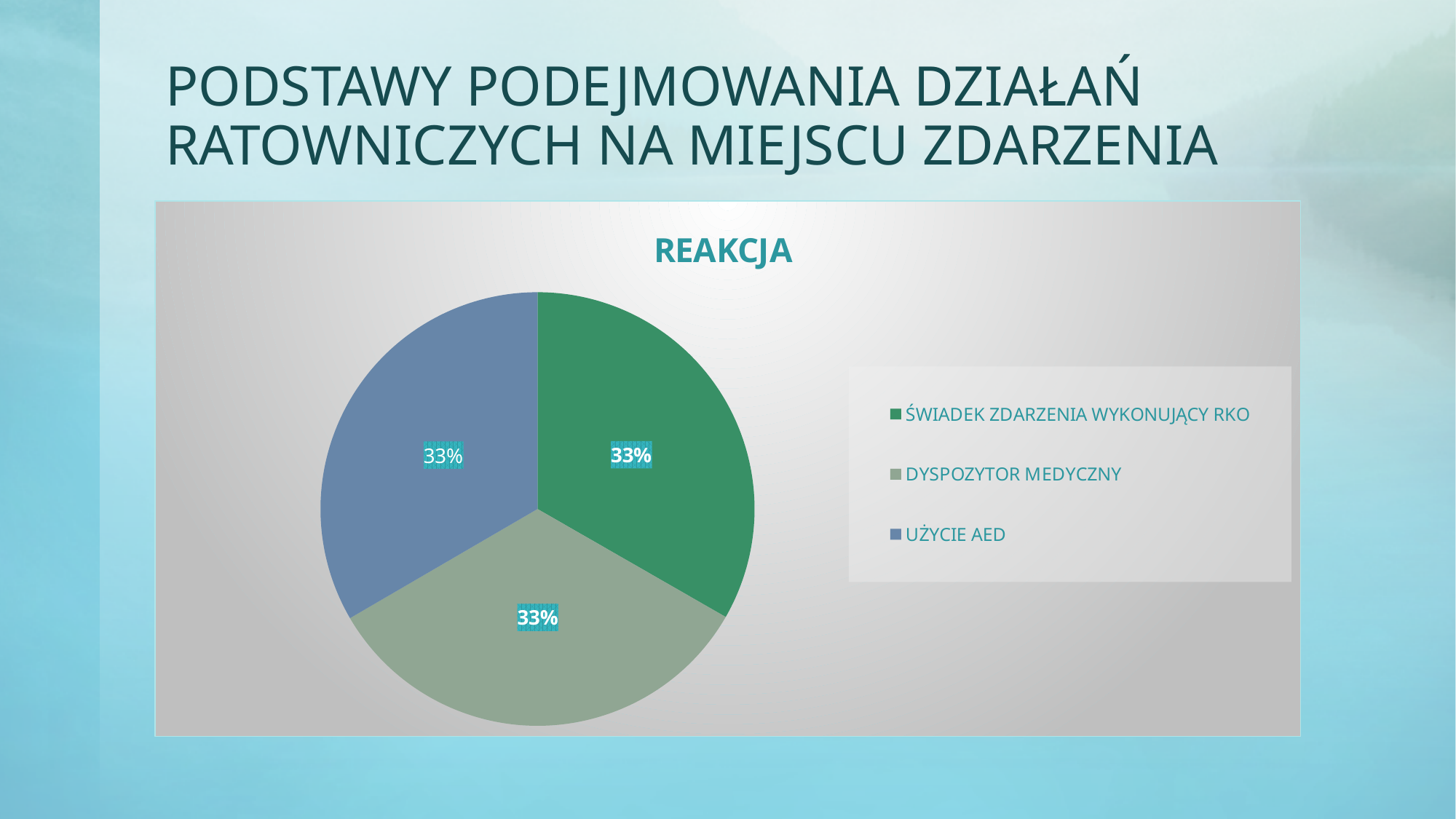
What is the difference between the shares of UŻYCIE AED and DYSPOZYTOR MEDYCZNY? 0% Which legend entry is shown in blue? UŻYCIE AED How many entries does the legend list? 3 What share of the pie does UŻYCIE AED represent? 33% What is the data label shown on the blue slice? 33% What is the title of the chart? REAKCJA How many slices does the pie chart have? 3 What share of the pie does ŚWIADEK ZDARZENIA WYKONUJĄCY RKO represent? 33% What kind of chart is shown on the slide? pie chart What share of the pie does DYSPOZYTOR MEDYCZNY represent? 33%